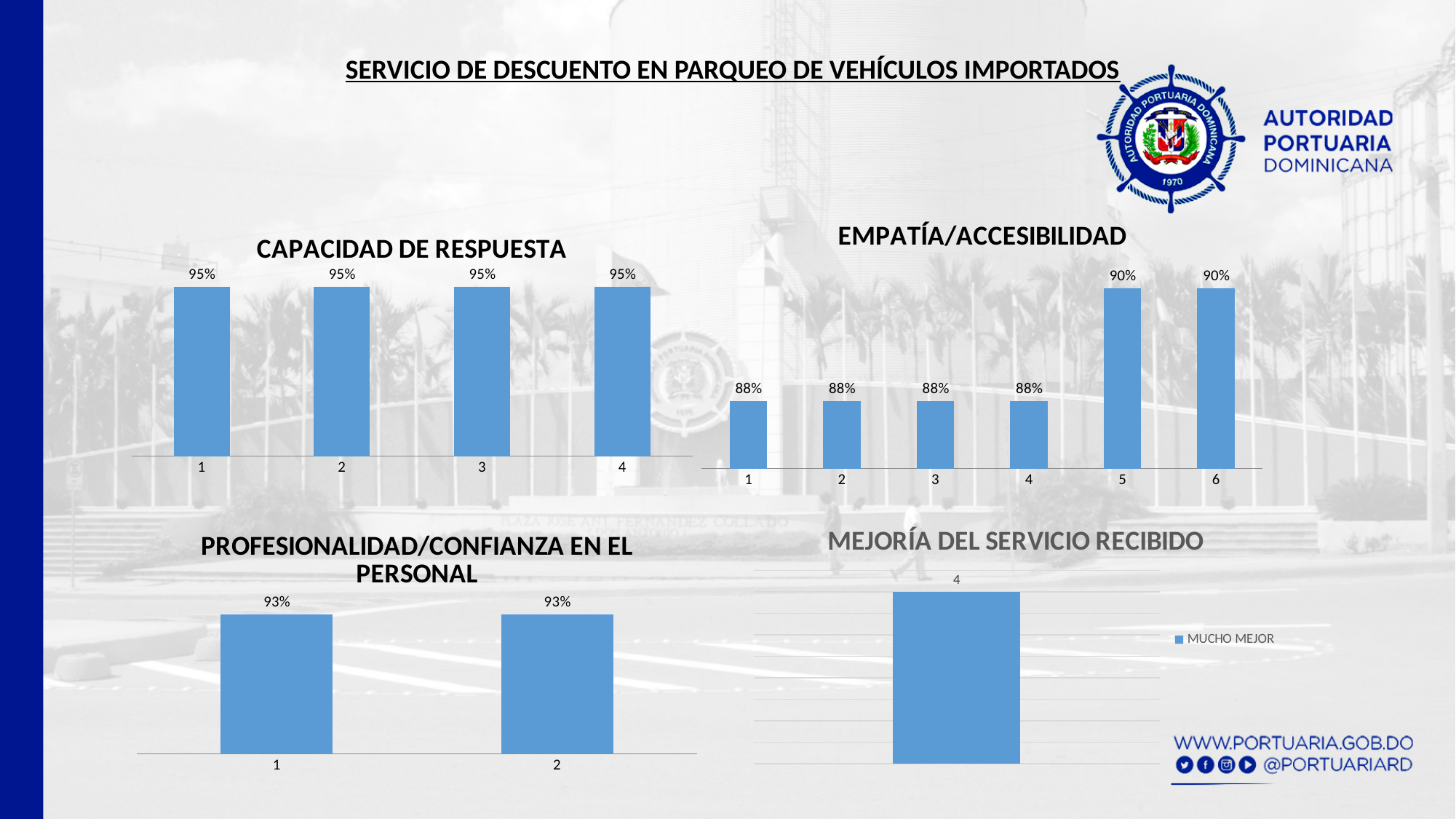
In the EMPATÍA/ACCESIBILIDAD chart, what is the value for category 5? 90% In the PROFESIONALIDAD/CONFIANZA EN EL PERSONAL chart, what is the value for category 2? 93% How many bars does the PROFESIONALIDAD/CONFIANZA EN EL PERSONAL chart have? 2 In the CAPACIDAD DE RESPUESTA chart, what is the value for category 1? 95% In the MEJORÍA DEL SERVICIO RECIBIDO chart, what value is labelled on the bar? 4 In the EMPATÍA/ACCESIBILIDAD chart, which is larger, the value for category 3 or the value for category 5? Category 5 What series does the legend of the MEJORÍA DEL SERVICIO RECIBIDO chart list? MUCHO MEJOR In the EMPATÍA/ACCESIBILIDAD chart, what is the value for category 2? 88% What type of chart is the CAPACIDAD DE RESPUESTA chart? Bar chart How many bars does the CAPACIDAD DE RESPUESTA chart have? 4 How many categories are shown in the EMPATÍA/ACCESIBILIDAD chart? 6 In the EMPATÍA/ACCESIBILIDAD chart, what is the difference between the values for category 6 and category 4? 2%